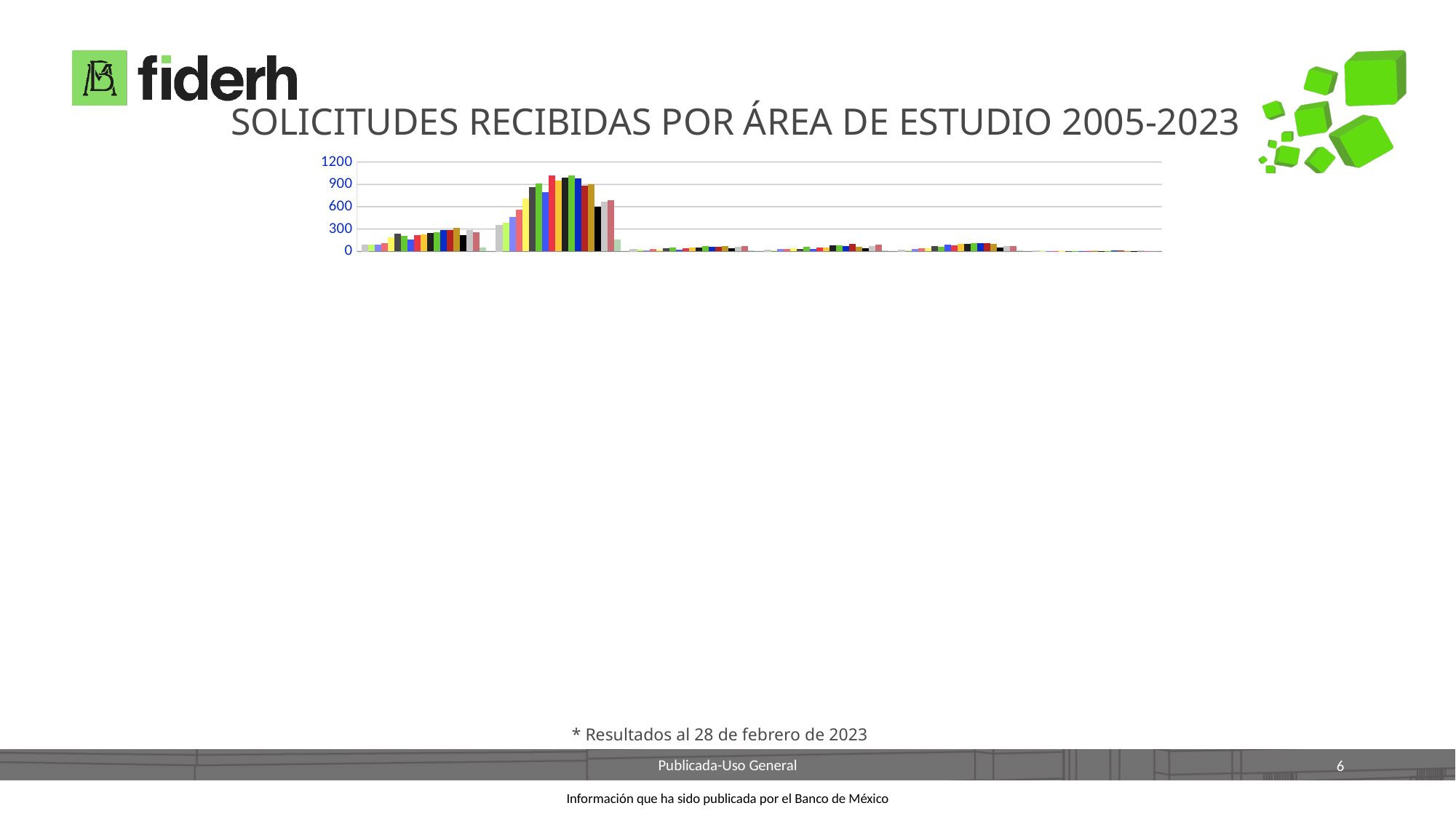
Is the tallest bar in the chart greater or less than 900? greater Is the tallest bar in the chart greater or less than 1200? less What is the title of the chart on the slide? SOLICITUDES RECIBIDAS POR ÁREA DE ESTUDIO 2005-2023 What kind of chart is shown on the slide? bar chart What is the highest value shown on the vertical axis of the chart? 1200